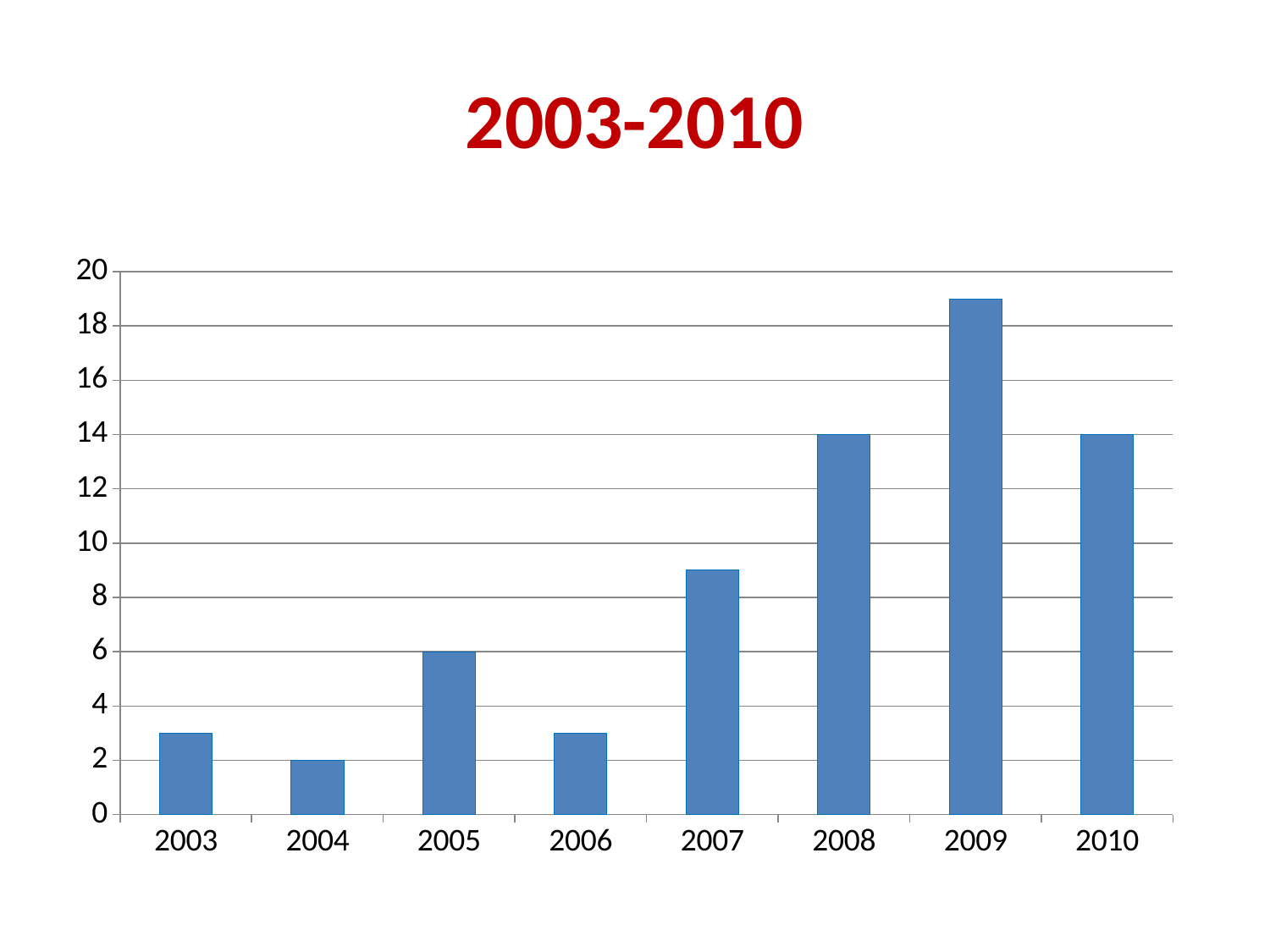
Which year has the lowest value? 2004 Is the value for 2009 greater or less than 18? greater What is the value for 2008? 14 What is the value for 2005? 6 What is the value for 2004? 2 What type of chart is shown on the slide? bar chart Is the value for 2007 greater or less than 10? less Which year has the highest value? 2009 How many years are shown on the x axis of the chart? 8 What is the difference between the values for 2008 and 2005? 8 What is the value for 2010? 14 What is the title of the chart? 2003-2010